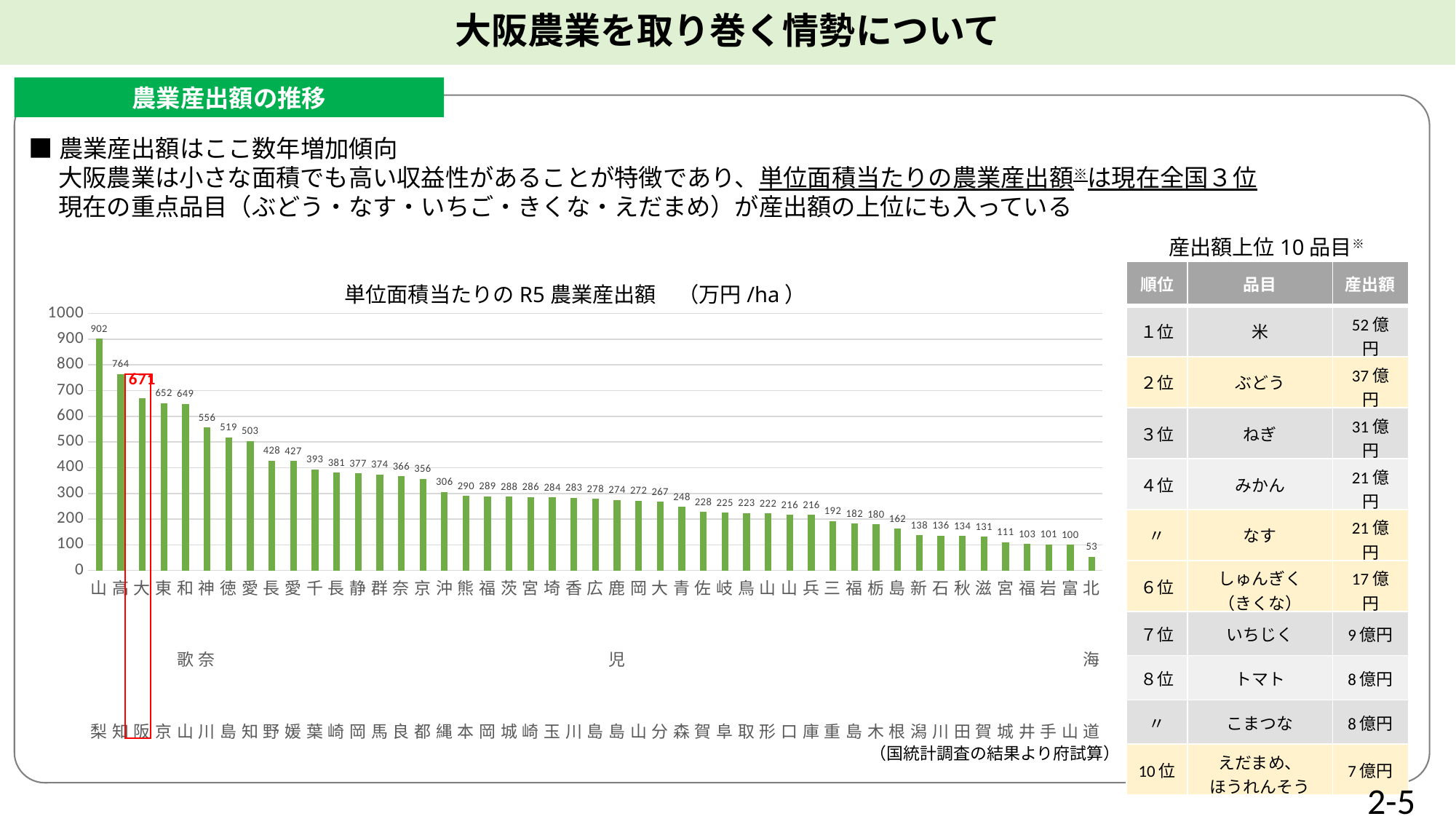
Which prefecture has the lowest value in the chart? 北海道 Which has a larger value, 高知 or 東京? 高知 Which prefecture has the highest value in the chart? 山梨 What unit is given in the chart title? 万円/ha What is the value for 大阪 in the chart 単位面積当たりのR5農業産出額? 671 What type of chart is shown on the slide? bar chart How many prefectures (bars) are plotted in the chart? 47 What is the difference between the values for 山梨 and 大阪? 231 Do the values rise or fall from left to right along the x axis? fall Is the value for 神奈川 greater or less than 500? greater What is the value for 北海道 in the chart? 53 What is the value for 山梨 in the chart? 902